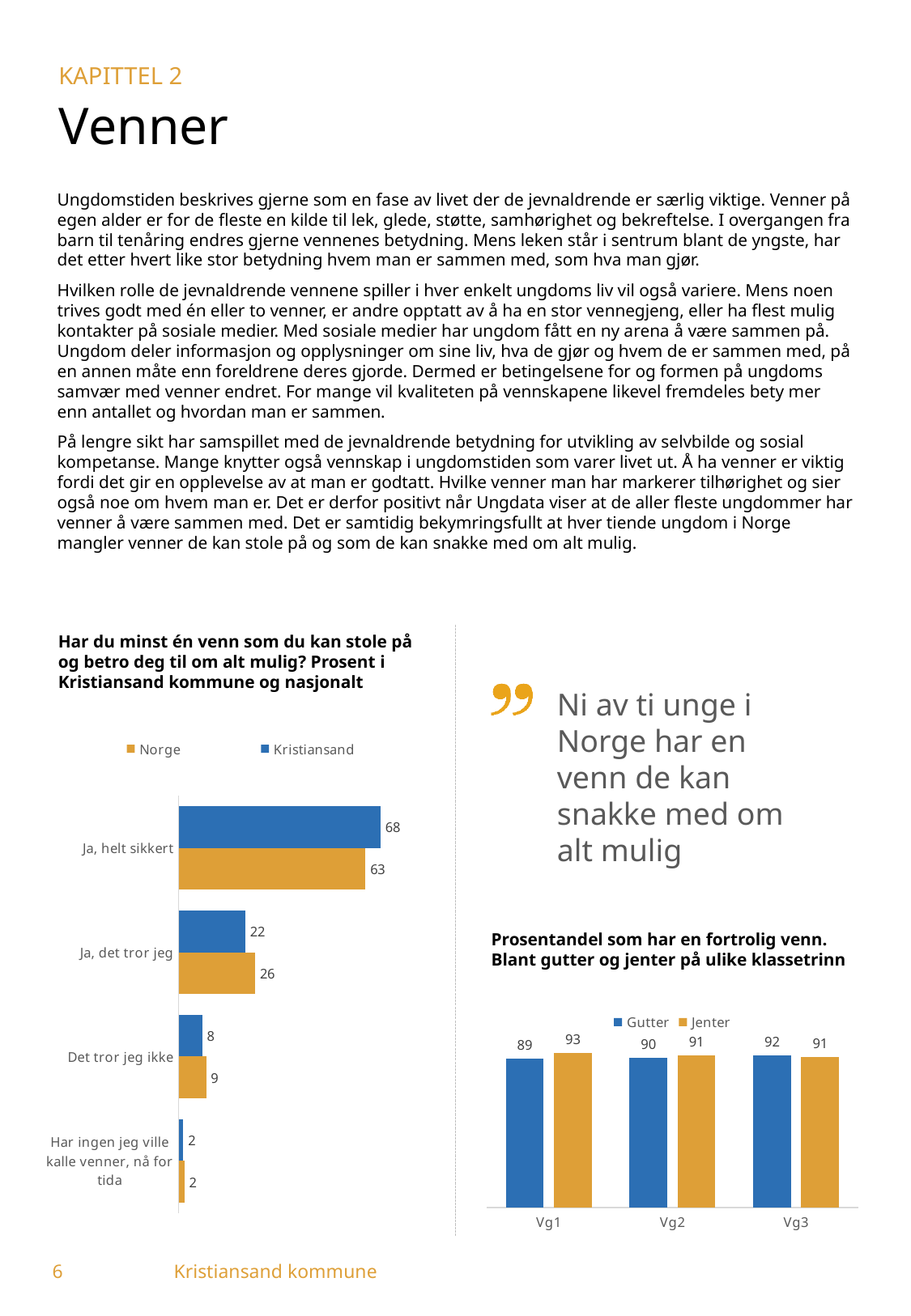
In the left chart (Har du minst én venn som du kan stole på...), what is the Norge value for 'Ja, det tror jeg'? 26 In the right chart (Prosentandel som har en fortrolig venn), what is the Jenter value for Vg1? 93 In the left chart (Har du minst én venn som du kan stole på...), which is larger for 'Det tror jeg ikke': Norge or Kristiansand? Norge In the left chart (Har du minst én venn som du kan stole på...), what is the Kristiansand value for 'Ja, helt sikkert'? 68 What type of chart is the left chart (Har du minst én venn som du kan stole på...)? Bar chart In the right chart (Prosentandel som har en fortrolig venn), what is the Gutter value for Vg3? 92 In the left chart (Har du minst én venn som du kan stole på...), how many categories are shown? 4 In the left chart (Har du minst én venn som du kan stole på...), which category has the lowest Kristiansand value? Har ingen jeg ville kalle venner, nå for tida In the right chart (Prosentandel som har en fortrolig venn), how many series does the legend list? 2 In the right chart (Prosentandel som har en fortrolig venn), do the Gutter values rise or fall from Vg1 to Vg3? Rise In the right chart (Prosentandel som har en fortrolig venn), what is the difference between Jenter and Gutter for Vg1? 4 In the left chart (Har du minst én venn som du kan stole på...), what is the difference between the Kristiansand and Norge values for 'Ja, helt sikkert'? 5